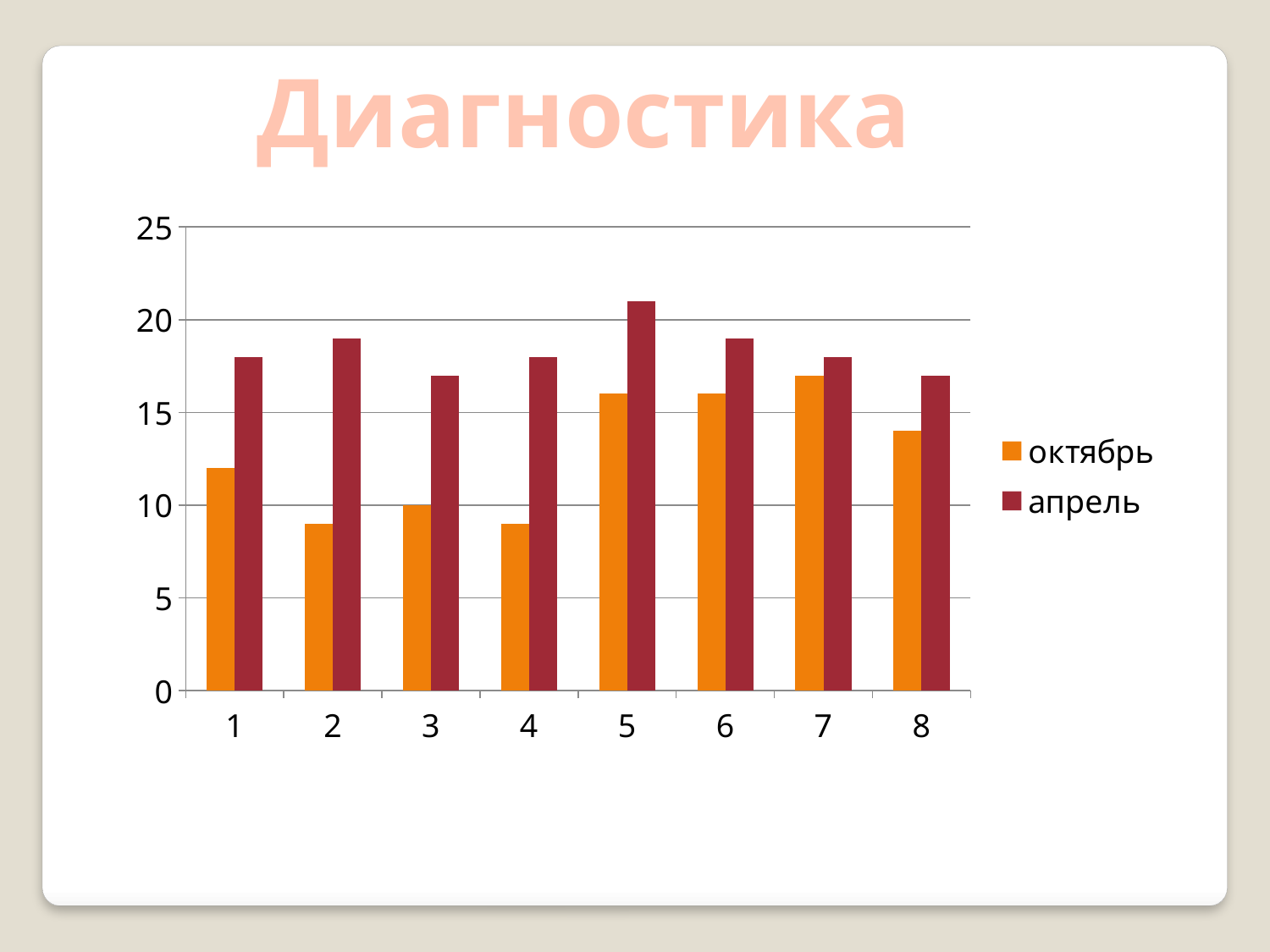
In category 1, which series has the larger value, октябрь or апрель? апрель Which series is shown in orange? октябрь Is the value for октябрь in category 1 greater or less than 10? greater What kind of chart is shown on the slide? bar chart How many categories are shown on the x axis? 8 What is the title of the slide above the chart? Диагностика How many series does the legend list? 2 Which category has the highest value for апрель? 5 Is the value for апрель in category 5 greater or less than 20? greater What is the value for октябрь in category 3? 10 Is the value for октябрь in category 4 greater or less than 10? less